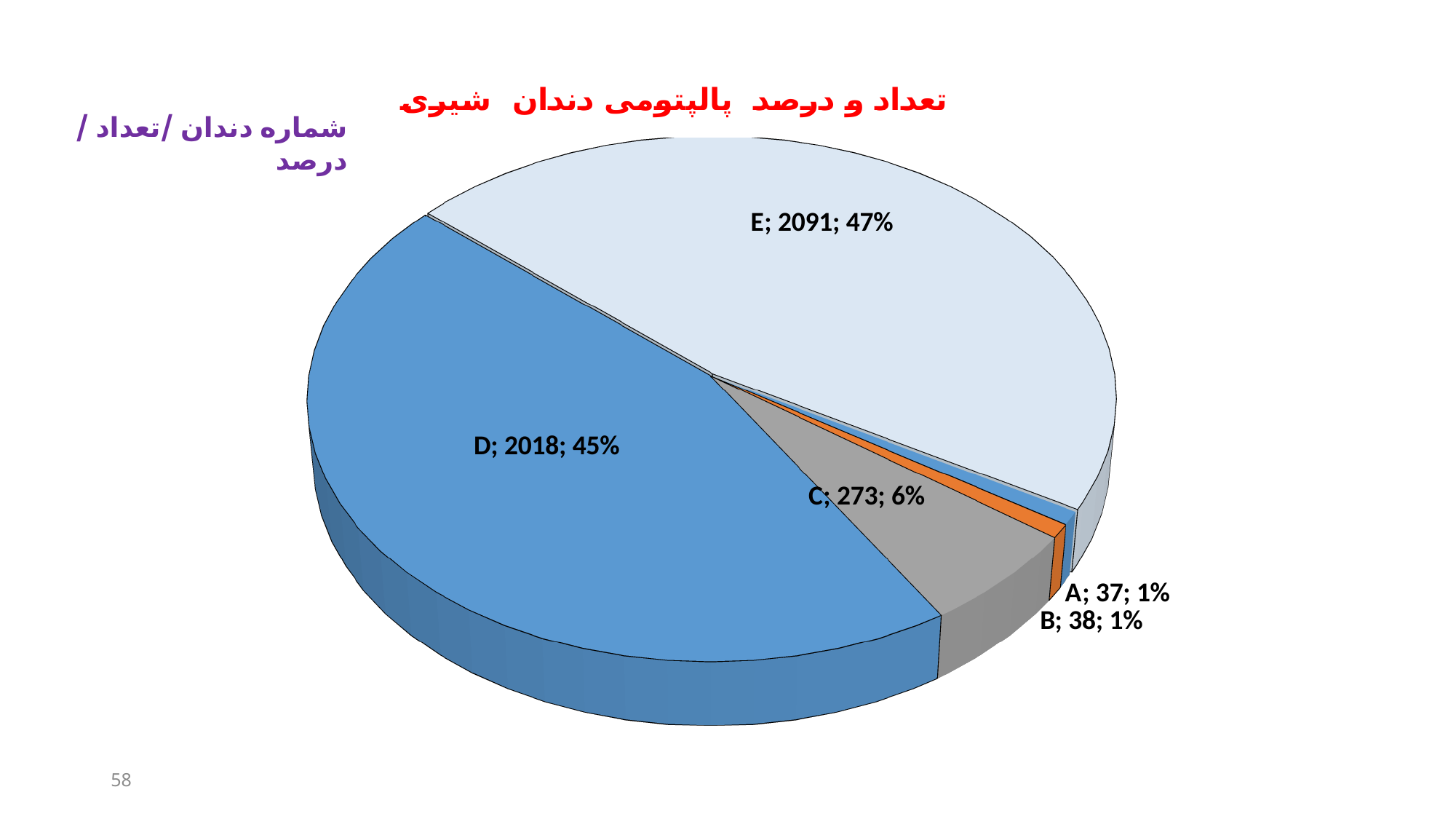
What is the count shown for tooth C? 273 What is the count shown for tooth B? 38 Which has a larger count, tooth C or tooth B? C Which tooth has the largest slice of the pie? E What is the count shown for tooth D? 2018 What percentage share of the pie does tooth C have? 6% What is the count shown for tooth E? 2091 What kind of chart is shown on the slide? pie chart Which tooth has the smallest count in the pie chart? A What is the difference between the counts for tooth E and tooth D? 73 How many slices does the pie chart have? 5 What percentage share of the pie does tooth E have? 47%